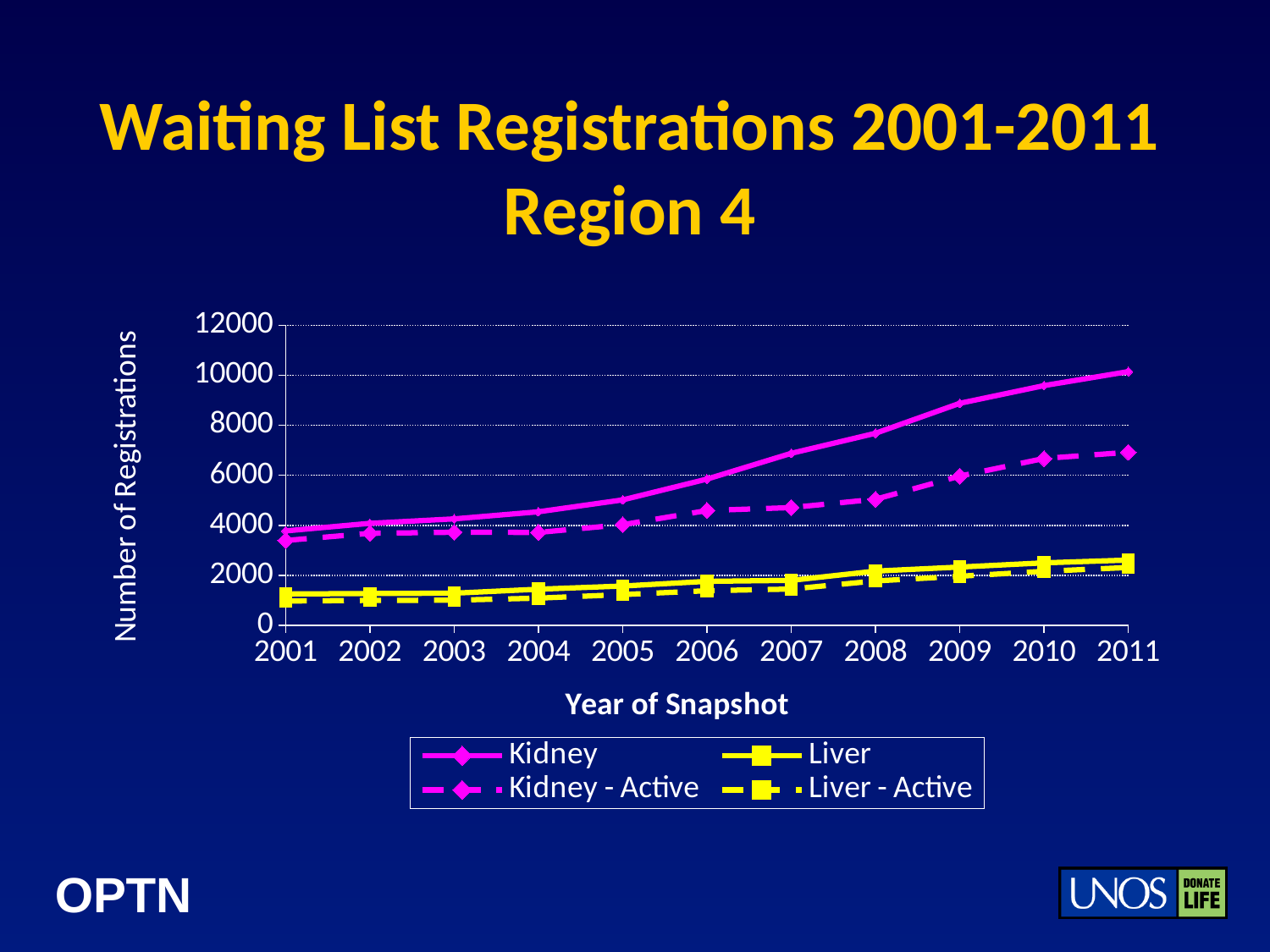
What is the label of the x axis? Year of Snapshot Which series has the highest value in 2011? Kidney Do the Kidney registrations rise or fall from 2001 to 2011? rise Is the value for Liver in 2001 greater or less than 2000? less How many series does the legend list? 4 What kind of chart is shown on the slide? line chart Which series has the lowest value in 2011? Liver - Active Which is larger in 2008, Kidney or Kidney - Active? Kidney Is the value for Kidney in 2001 greater or less than 4000? less How many years are plotted along the x axis? 11 Is the value for Kidney in 2011 greater or less than 8000? greater